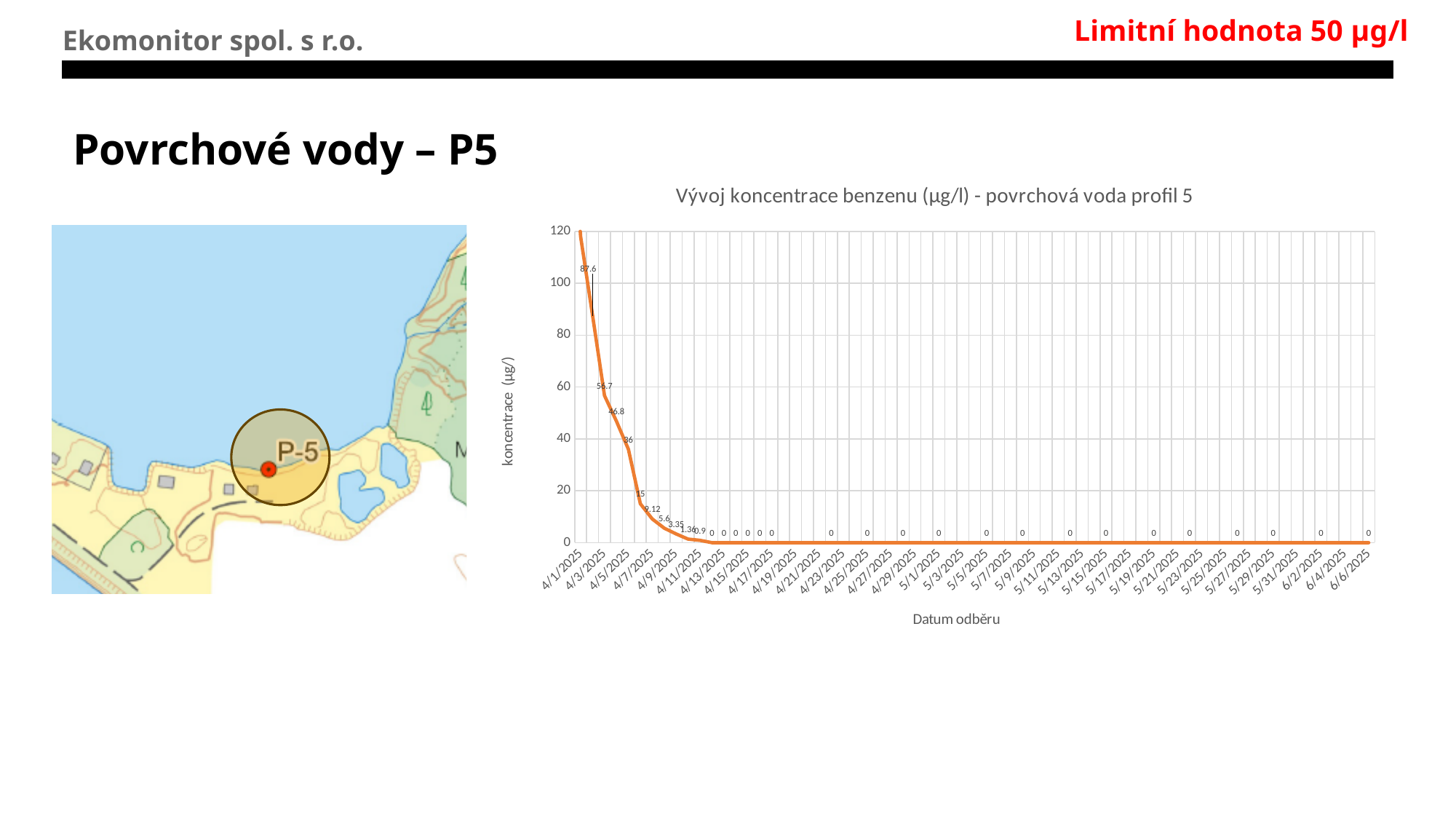
What is the benzene concentration on 5/1/2025? 0 What is the benzene concentration on 4/3/2025? 56.7 What is the benzene concentration on 4/5/2025? 36 Is the benzene concentration on 4/1/2025 greater or less than 100? greater Which date has the higher benzene concentration, 4/3/2025 or 4/7/2025? 4/3/2025 What is the title of the chart? Vývoj koncentrace benzenu (µg/l) - povrchová voda profil 5 What kind of chart is shown on the slide? line chart Do the benzene concentration values rise or fall along the x axis over time? fall What is the difference between the benzene concentration on 4/3/2025 and on 4/5/2025? 20.7 What is the benzene concentration on 4/11/2025? 0.9 What is the benzene concentration on 4/7/2025? 9.12 What limit value is stated in red at the top right of the slide? 50 µg/l